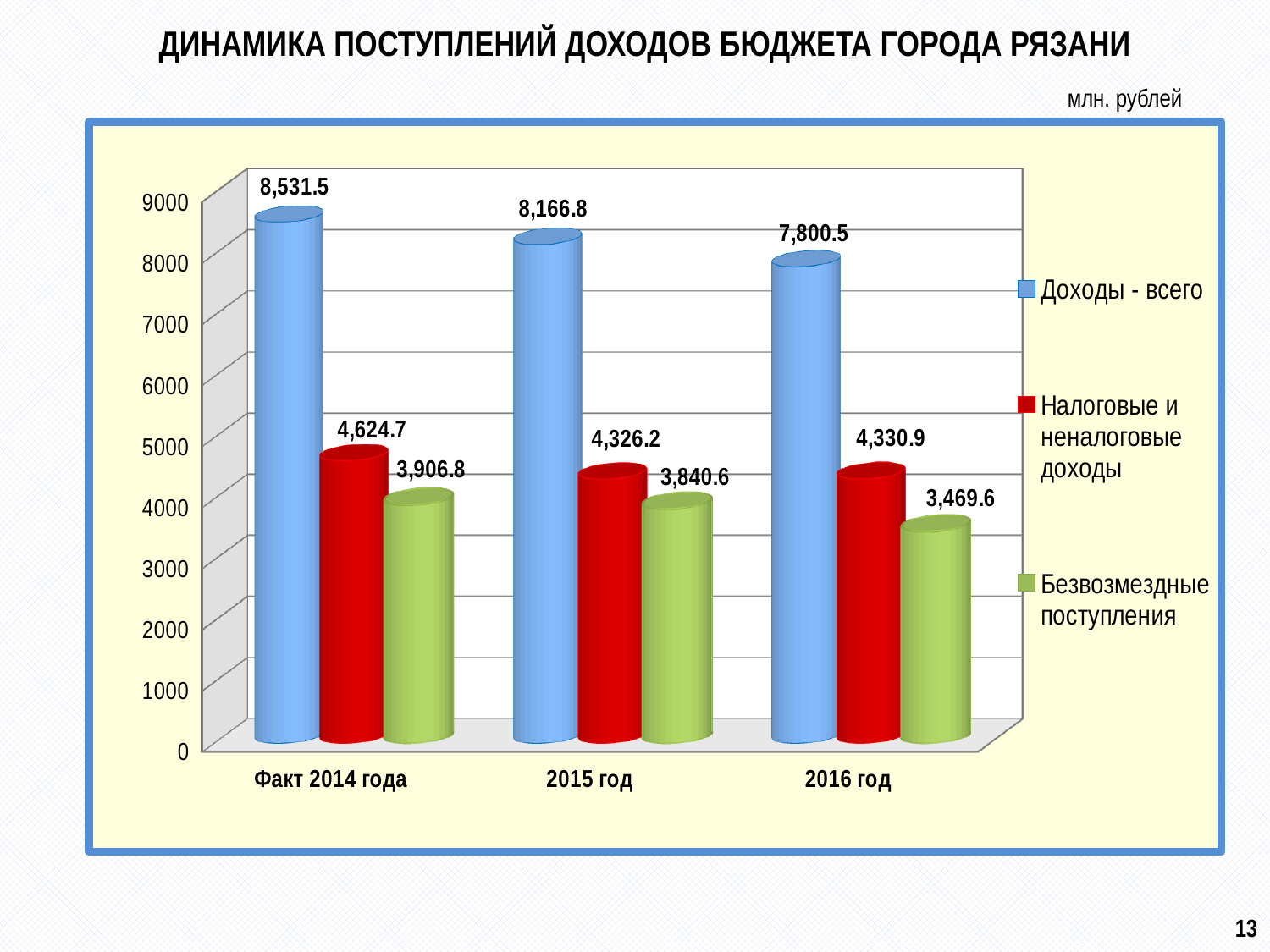
What is the value of Налоговые и неналоговые доходы for 2015 год? 4,326.2 How many series does the legend list? 3 What is the difference between Безвозмездные поступления for Факт 2014 года and for 2016 год? 437.2 What is the difference between Доходы - всего for Факт 2014 года and for 2015 год? 364.7 Which is larger: Налоговые и неналоговые доходы for Факт 2014 года or for 2015 год? Факт 2014 года How many categories are shown on the x axis? 3 In which category is Доходы - всего the lowest? 2016 год Do the values of Доходы - всего rise or fall from Факт 2014 года to 2016 год? Fall In which category is Безвозмездные поступления the highest? Факт 2014 года What is the value of Безвозмездные поступления for 2016 год? 3,469.6 What is the value of Доходы - всего for Факт 2014 года? 8,531.5 What kind of chart is shown on the slide? Bar chart